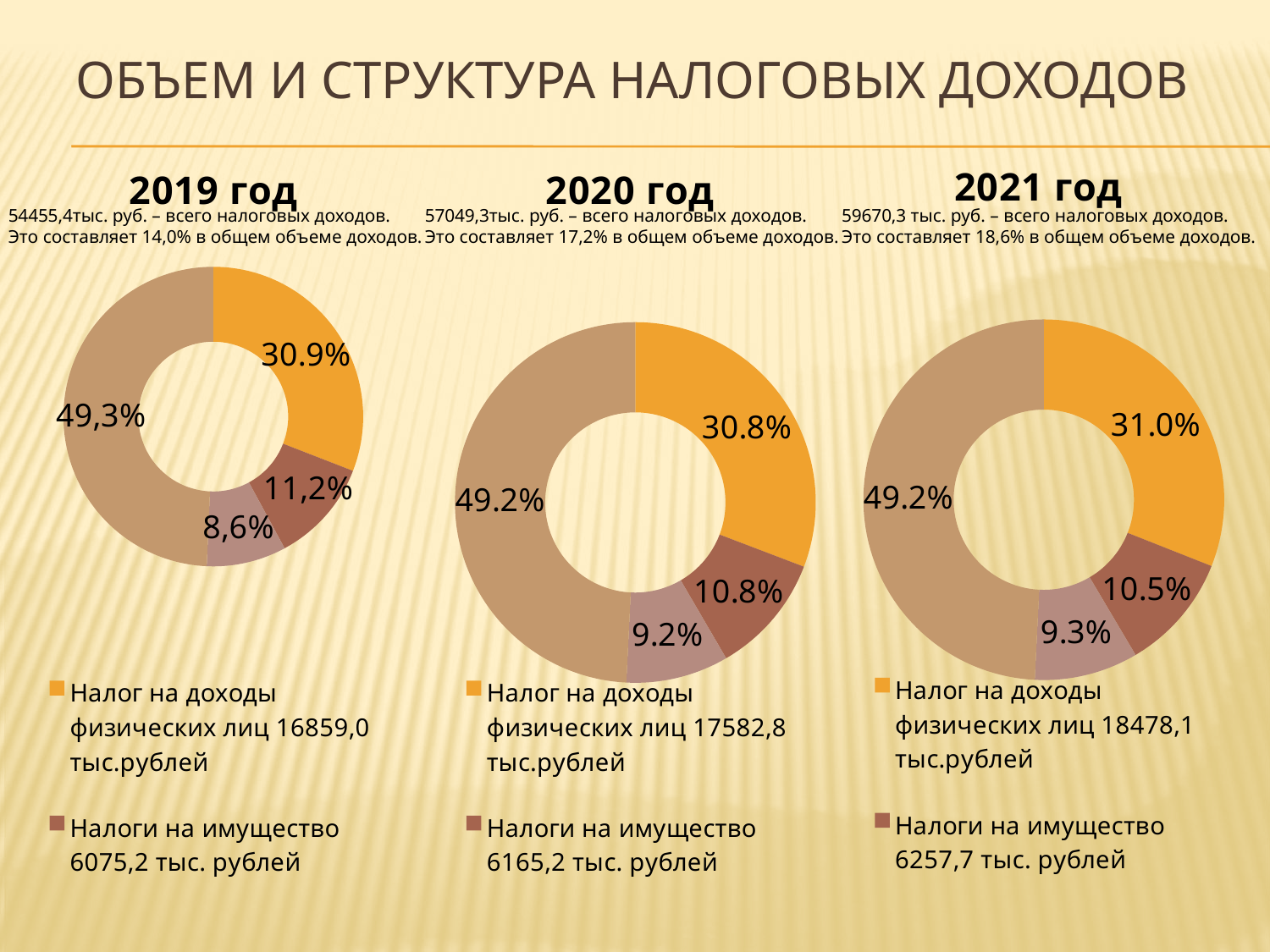
What kind of chart is used for the 2021 год data? Doughnut chart How many entries does the legend under the 2019 год chart list? 2 According to the legend under the 2021 год chart, what amount is given for Налоги на имущество? 6257,7 тыс. рублей In the 2019 год chart, what percentage is shown for the slice labelled Налог на доходы физических лиц (orange)? 30.9% In the 2019 год chart, what is the value of the largest slice? 49,3% In the 2020 год chart, what percentage is shown for the Налоги на имущество slice (dark brown)? 10.8% In the 2020 год chart, what is the value of the smallest slice? 9.2% In the 2021 год chart, what is the value of the smallest slice? 9.3% In the 2021 год chart, what percentage is shown for the Налог на доходы физических лиц slice (orange)? 31.0% In the 2020 год chart, what is the difference between the Налог на доходы физических лиц slice (30.8%) and the Налоги на имущество slice (10.8%)? 20.0% In the 2021 год chart, which is larger: the Налог на доходы физических лиц slice or the Налоги на имущество slice? Налог на доходы физических лиц How many slices does the 2020 год chart have? 4